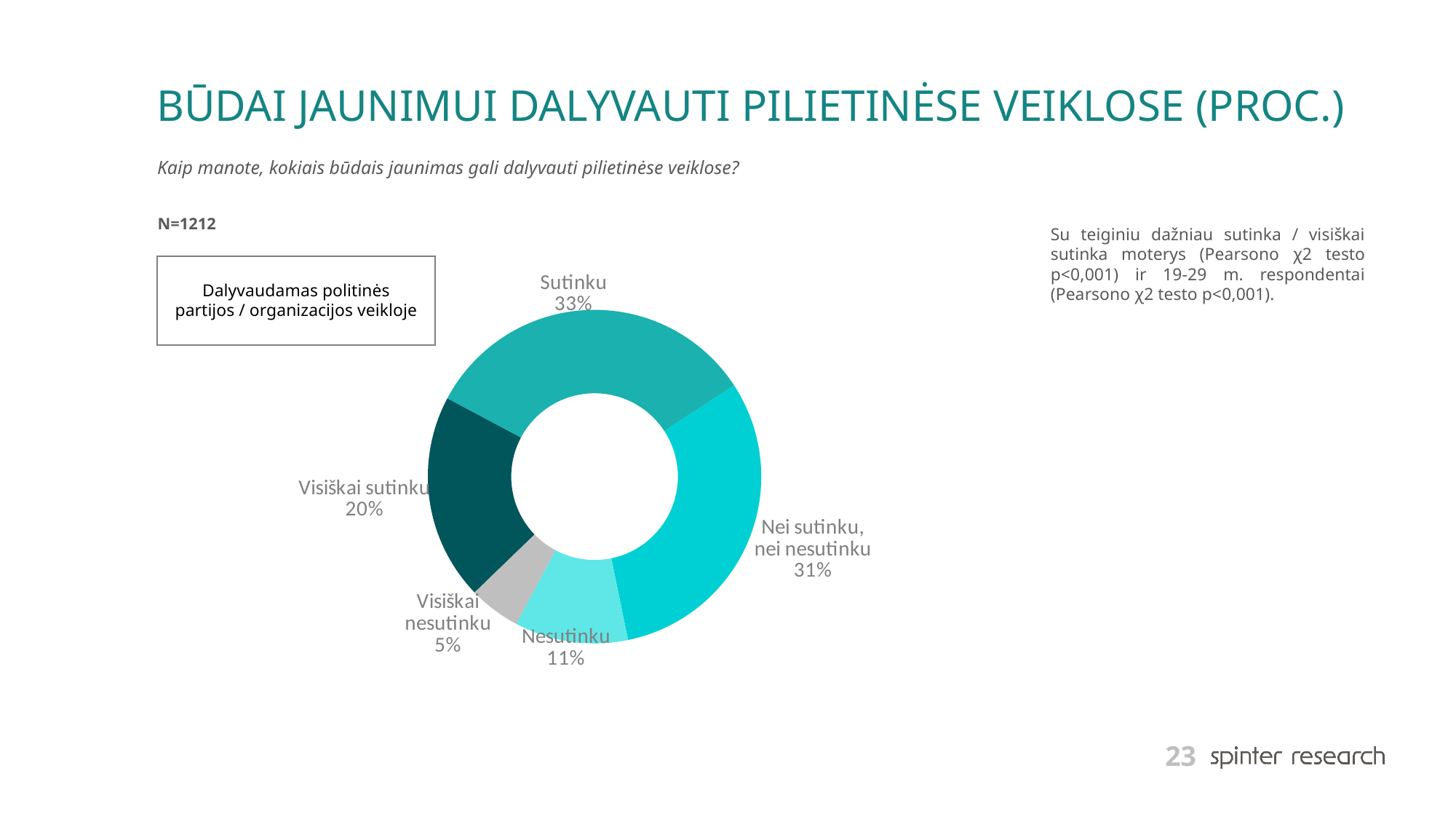
What percentage of respondents answered 'Visiškai nesutinku'? 5% How many response categories are shown in the chart? 5 Which is larger, the share for 'Visiškai sutinku' or the share for 'Nesutinku'? Visiškai sutinku What is the combined share of 'Sutinku' and 'Visiškai sutinku'? 53% Which response category has the largest share? Sutinku What kind of chart is shown on the slide? Pie chart (doughnut) What percentage of respondents answered 'Nei sutinku, nei nesutinku'? 31% What is the sample size (N) stated on the slide? N=1212 What percentage of respondents answered 'Visiškai sutinku'? 20% What percentage of respondents answered 'Sutinku'? 33% Which response category has the smallest share? Visiškai nesutinku What is the difference in percentage points between 'Sutinku' and 'Nesutinku'? 22